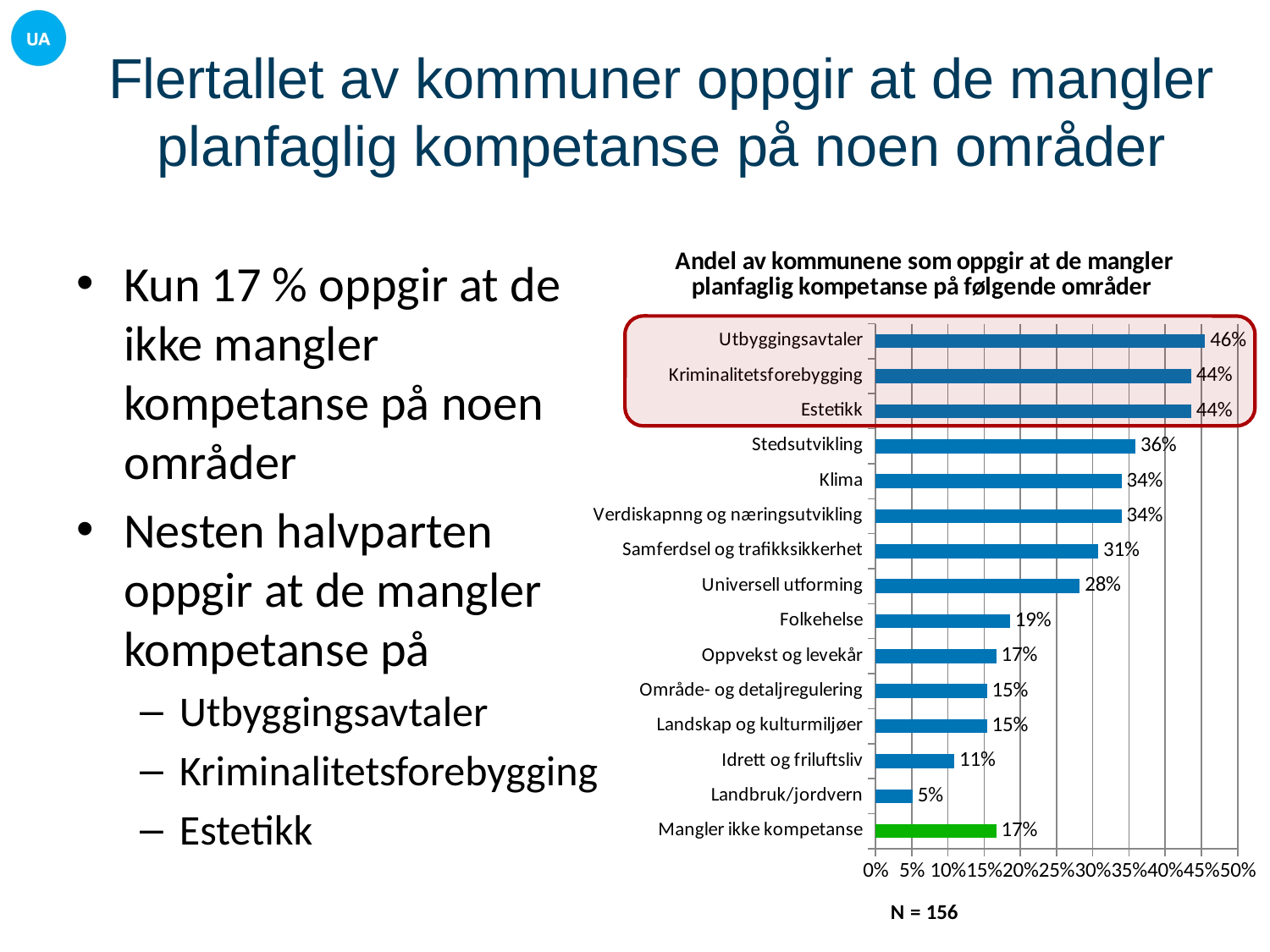
What is the sample size (N) shown below the chart? N = 156 Which category has the lowest value? Landbruk/jordvern What is the title of the chart? Andel av kommunene som oppgir at de mangler planfaglig kompetanse på følgende områder What is the value for Landbruk/jordvern? 5% What is the value for Mangler ikke kompetanse? 17% How many categories are shown in the chart? 15 What kind of chart is shown on the slide? Bar chart Which is larger, the value for Folkehelse or the value for Universell utforming? Universell utforming What is the value for Stedsutvikling? 36% What is the difference between the values for Utbyggingsavtaler and Stedsutvikling? 10% Which category has the highest value? Utbyggingsavtaler What is the value for Utbyggingsavtaler? 46%